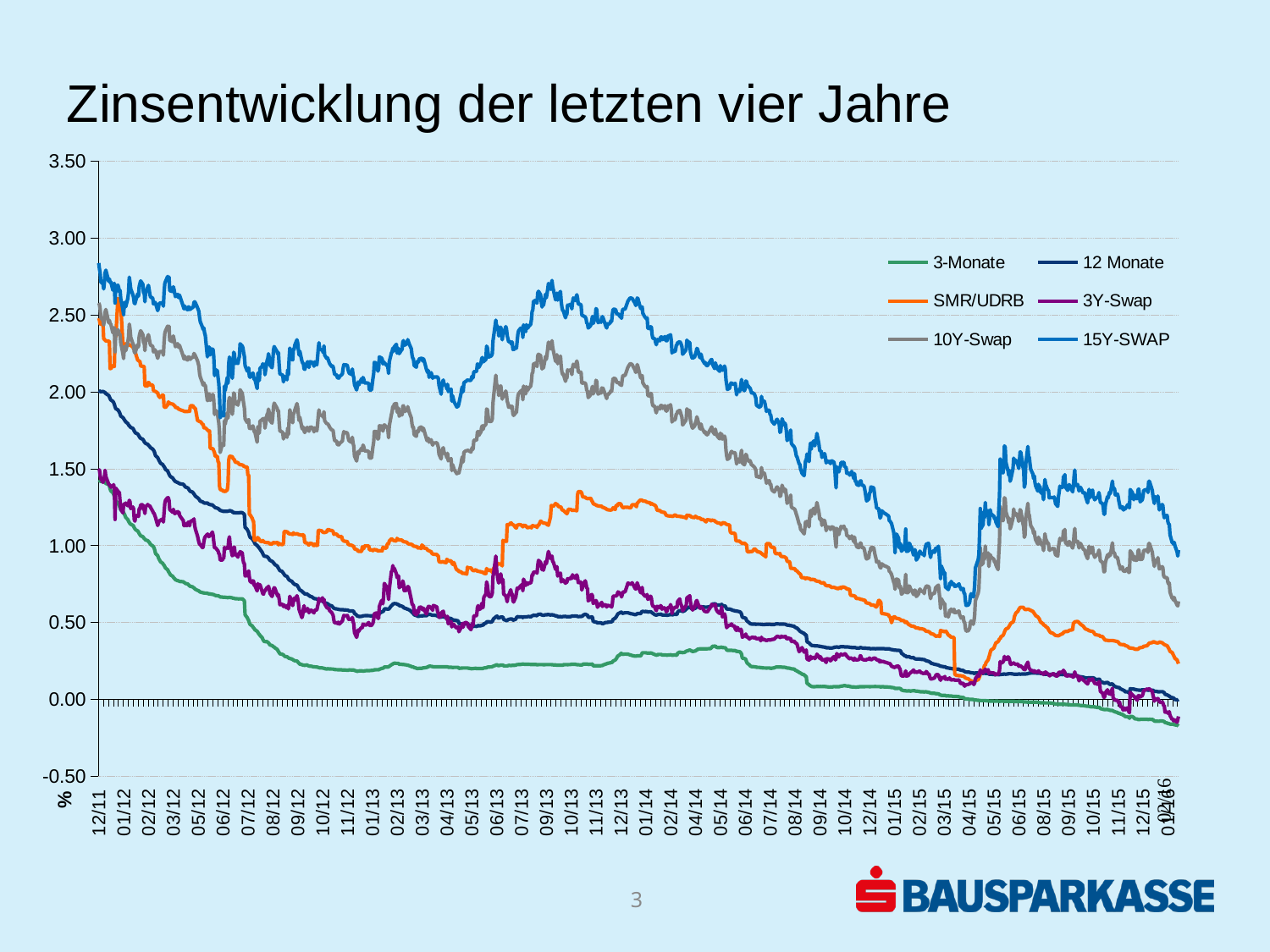
Does the 3-Monate series rise or fall overall from 12/11 to 01/16? fall Is the value for 10Y-Swap at 09/13 greater or less than 2.00? greater Which series is higher at 12/11, 15Y-SWAP or 3-Monate? 15Y-SWAP Which series has the highest values across the chart? 15Y-SWAP Is the value for 3-Monate at 01/16 greater or less than 0.00? less What unit is shown on the y axis of the chart? % Is the value for SMR/UDRB at 04/15 greater or less than 0.50? less What kind of chart is shown on the slide? line chart What is the title of the chart? Zinsentwicklung der letzten vier Jahre Does the 15Y-SWAP series rise or fall overall from 12/11 to 01/16? fall How many series does the legend list? 6